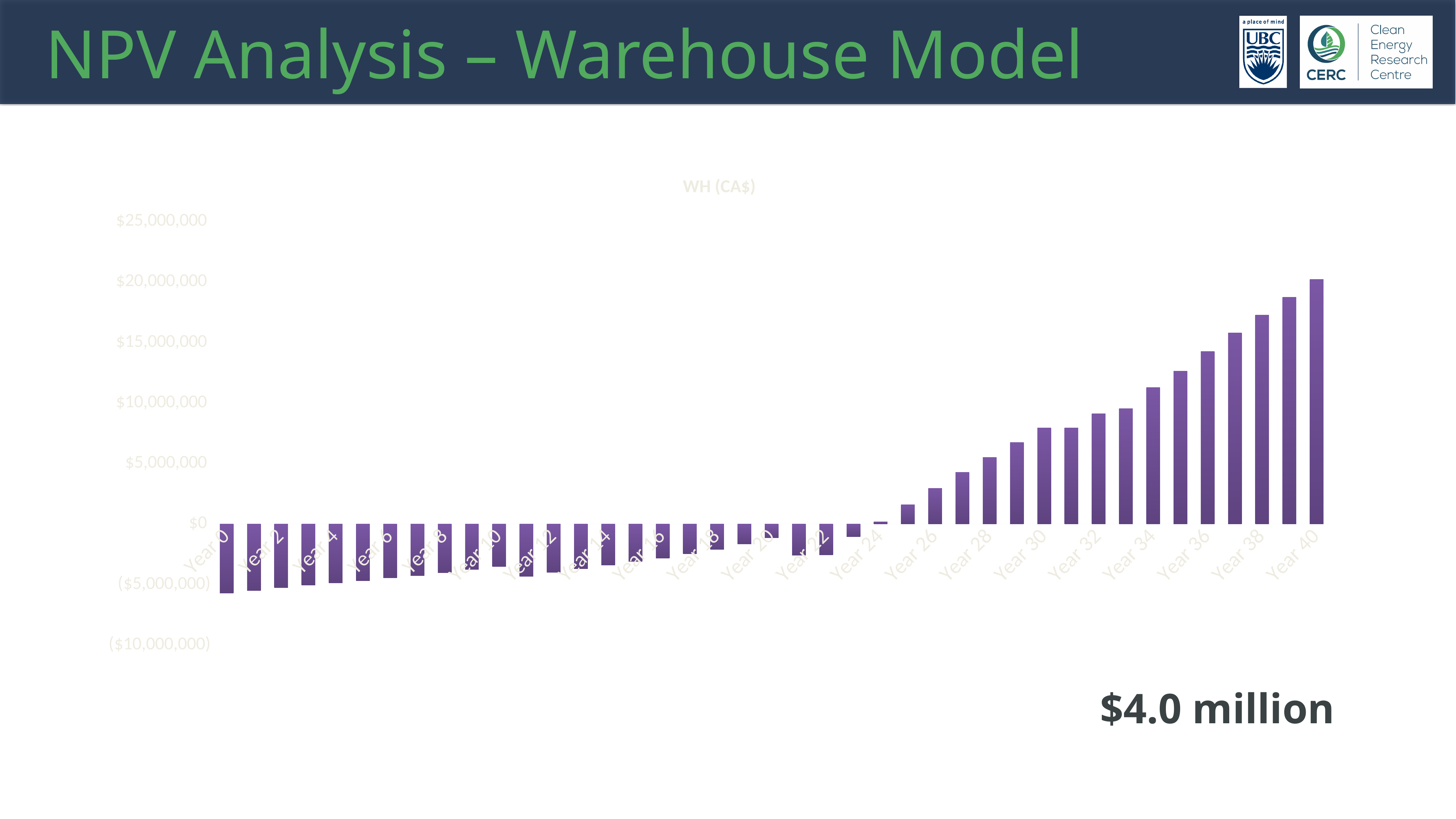
What colour are the bars in the chart? purple Which is larger, the value for Year 30 or the value for Year 40? Year 40 Do the values generally rise or fall from Year 0 to Year 40? rise Which is higher, the value for Year 10 or the value for Year 20? Year 20 Is the value for Year 34 greater or less than $10,000,000? greater What is the title of the chart? WH (CA$) Is the value for Year 0 greater or less than $0? less Is the value for Year 26 greater or less than $5,000,000? less What kind of chart is shown on the slide? bar chart Which year has the highest value in the chart? Year 40